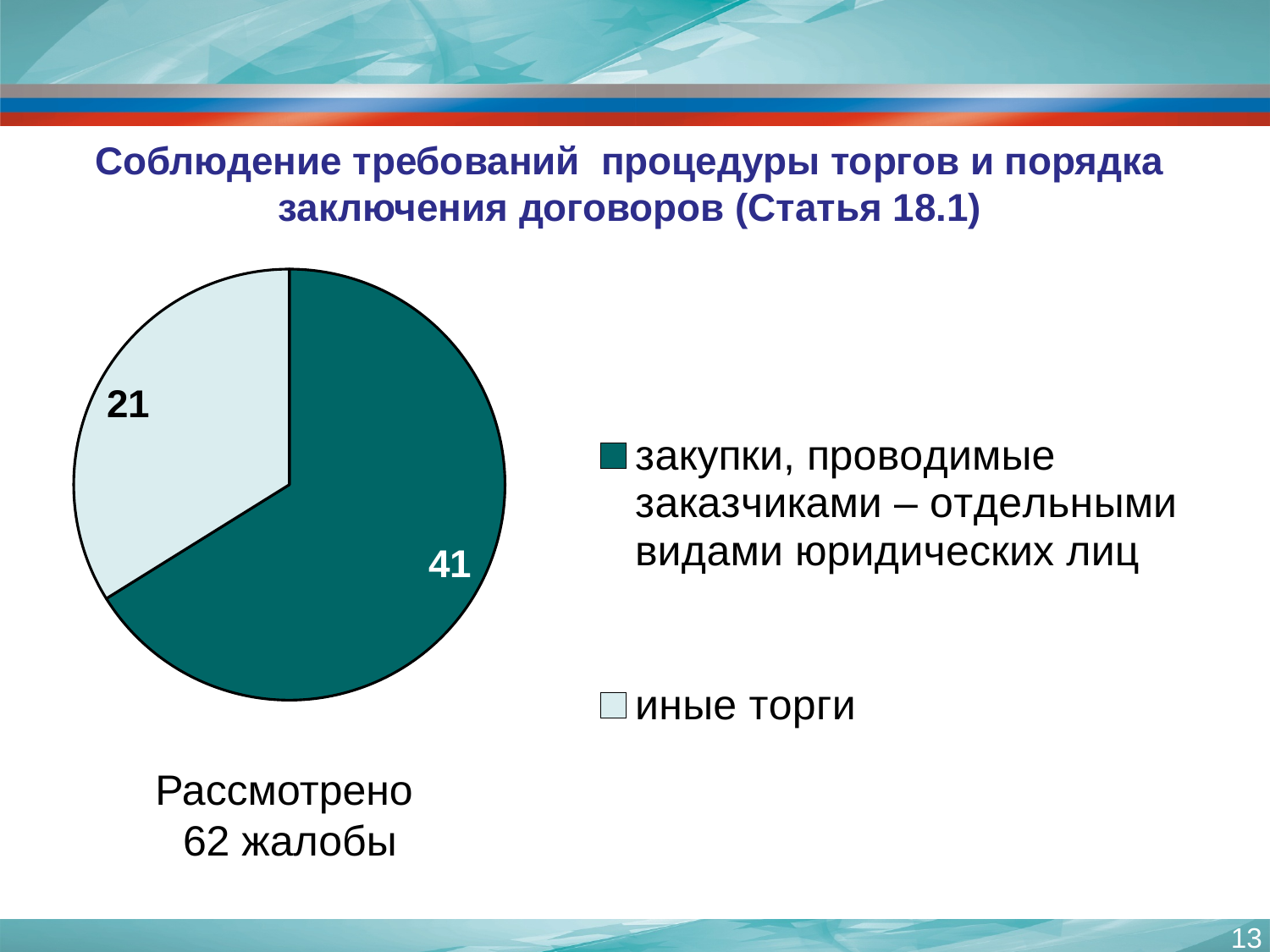
Which category has the largest slice? закупки, проводимые заказчиками – отдельными видами юридических лиц What kind of chart is shown on the slide? pie chart What is the value for 'закупки, проводимые заказчиками – отдельными видами юридических лиц'? 41 Which is larger: the value for 'иные торги' or the value for 'закупки, проводимые заказчиками – отдельными видами юридических лиц'? закупки, проводимые заказчиками – отдельными видами юридических лиц What colour is the slice for 'иные торги'? light blue Which category has the smallest slice? иные торги What is the title of the slide above the chart? Соблюдение требований процедуры торгов и порядка заключения договоров (Статья 18.1) What is the total of the two slices in the pie chart? 62 How many entries does the legend list? 2 How many slices does the pie chart have? 2 What is the value for 'иные торги'? 21 What is the difference between the values for 'закупки, проводимые заказчиками – отдельными видами юридических лиц' and 'иные торги'? 20